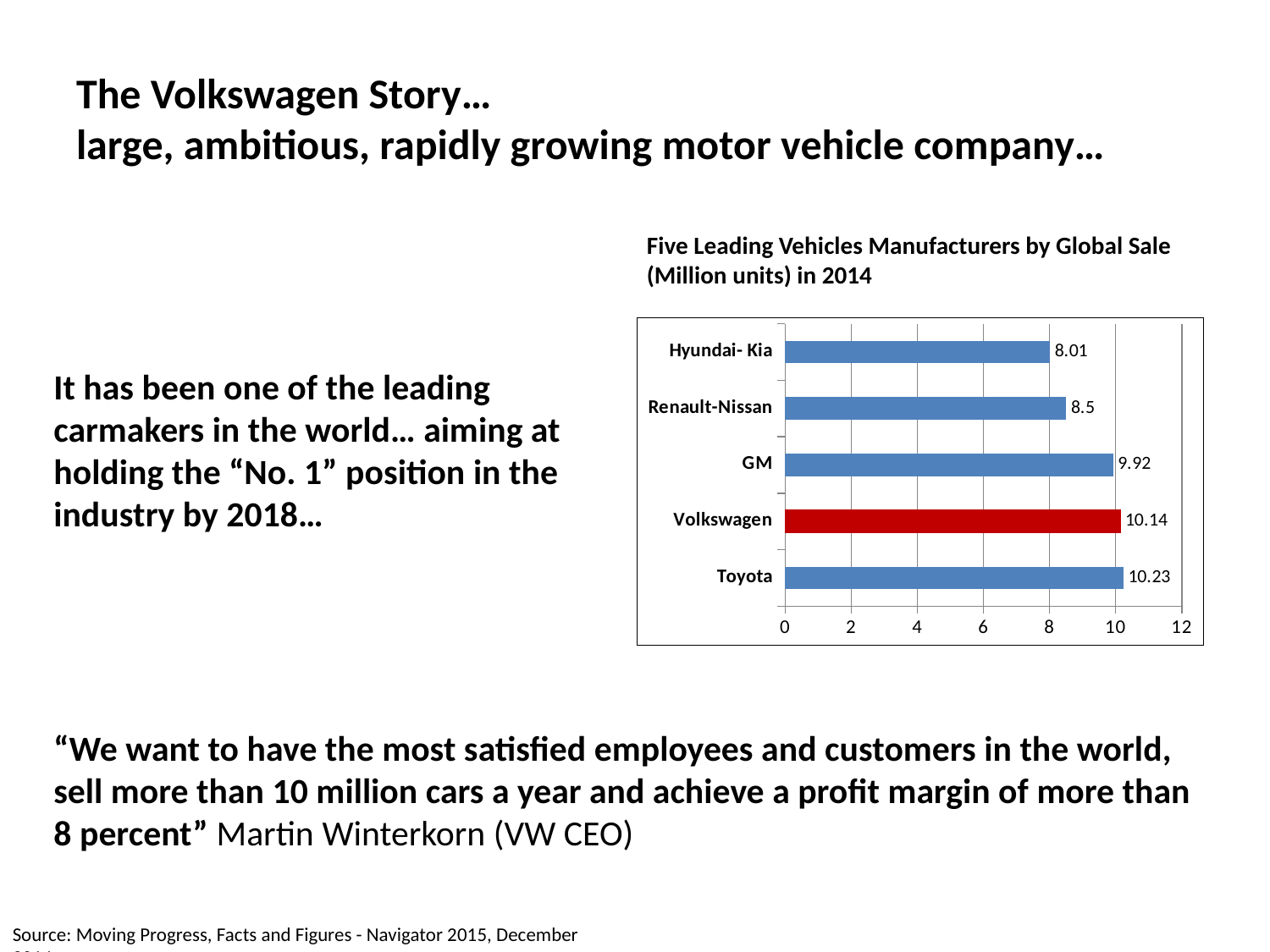
Which manufacturer has the highest global sales? Toyota What is the difference between Toyota's and Volkswagen's global sales? 0.09 What is the global sales value for GM? 9.92 What is the global sales value for Hyundai- Kia? 8.01 How many manufacturers are shown in the chart? 5 What is the global sales value for Volkswagen? 10.14 Which manufacturer's bar is coloured red in the chart? Volkswagen Is the value for Renault-Nissan greater or less than 10? less What kind of chart is shown on the slide? bar chart What is the difference between Renault-Nissan's and Hyundai- Kia's global sales? 0.49 Which manufacturer has the lowest global sales? Hyundai- Kia Which has larger global sales, GM or Renault-Nissan? GM